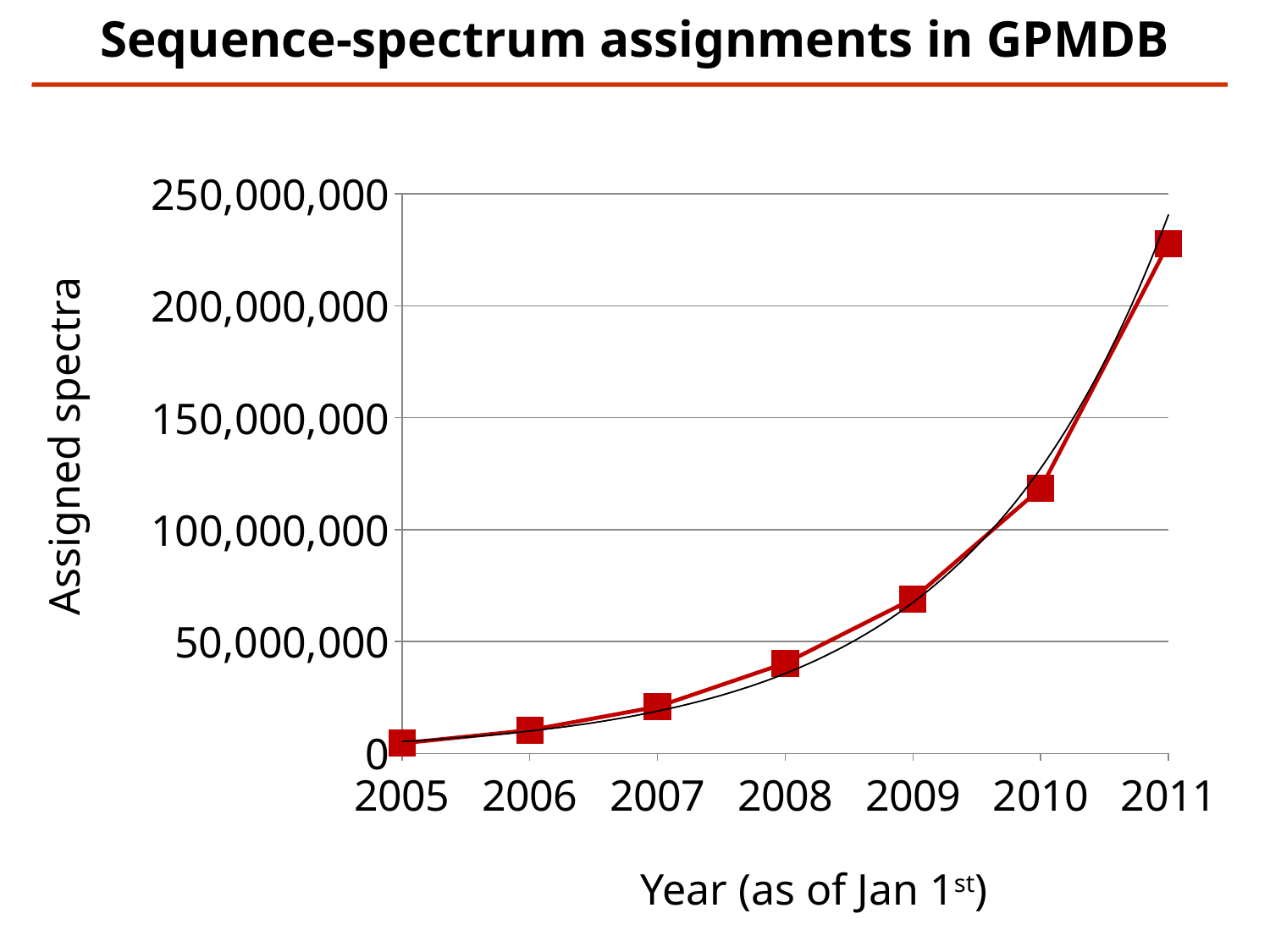
Is the value for 2011 greater or less than 200,000,000? greater Is the value for 2008 greater or less than 50,000,000? less Which year has more assigned spectra, 2009 or 2010? 2010 What kind of chart is shown on the slide? line chart Is the value for 2010 greater or less than 100,000,000? greater How many years are plotted on the x axis? 7 Which year has the lowest number of assigned spectra? 2005 Do the assigned spectra rise or fall from 2005 to 2011? rise What is the title of the chart? Sequence-spectrum assignments in GPMDB Which year has the highest number of assigned spectra? 2011